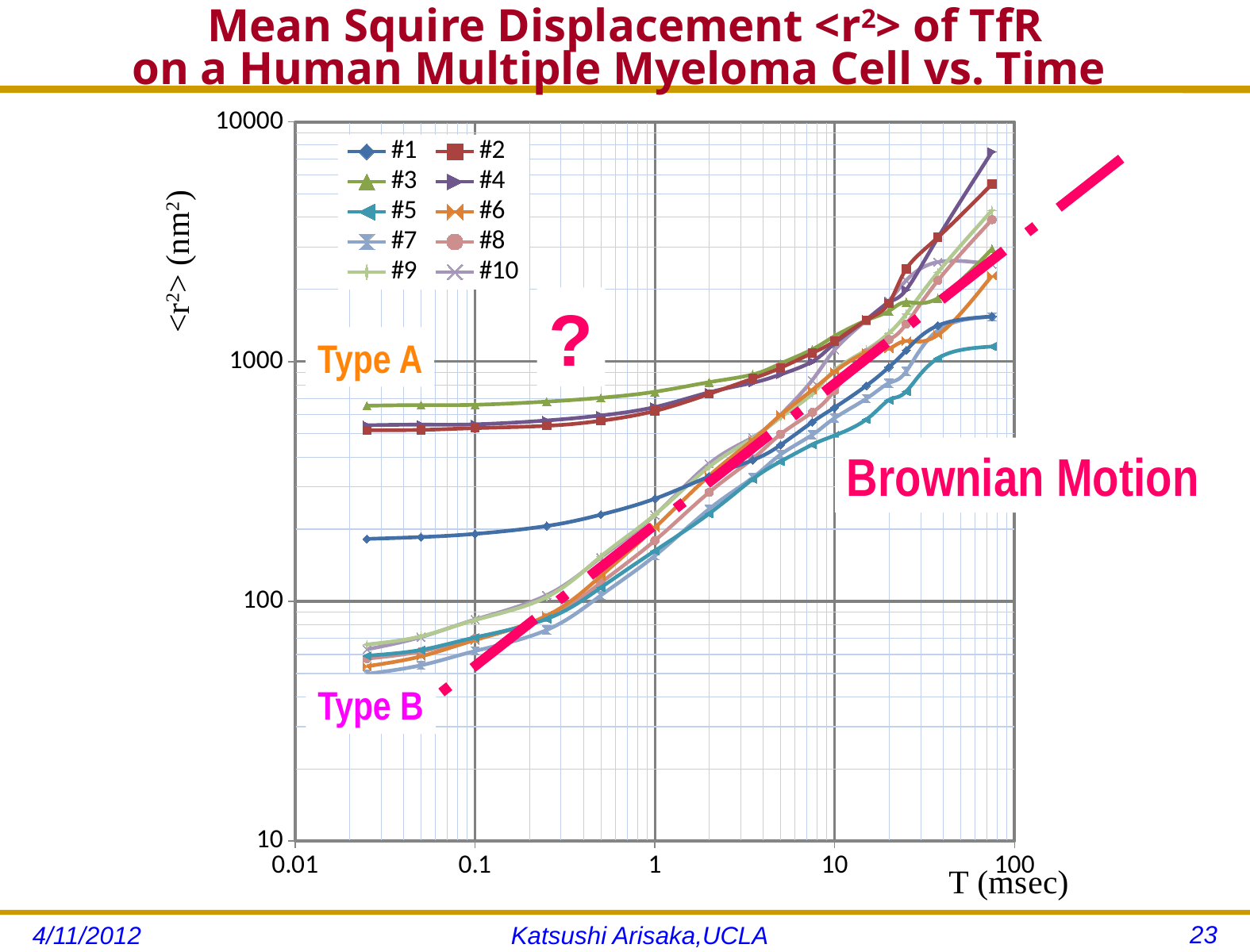
Which series has the highest <r²> value at the largest T plotted (near 100 msec)? #4 Do the <r²> values rise or fall as T increases along the x axis? rise Is the value of series #4 at its largest T greater or less than 1000 nm²? greater How many series does the legend list? 10 What is the label on the y axis of the chart? <r²> (nm²) What kind of chart is shown on the slide? line chart Which series has the lowest <r²> value at the largest T plotted (near 100 msec)? #5 What is the label on the x axis of the chart? T (msec) At T = 1 msec, which series has the larger <r²> value, #3 or #1? #3 Is the value of series #3 at T = 0.1 msec greater or less than 100 nm²? greater Is the value of series #5 at T = 0.1 msec greater or less than 100 nm²? less Which series has the highest <r²> value at the smallest T plotted (near 0.02 msec)? #3